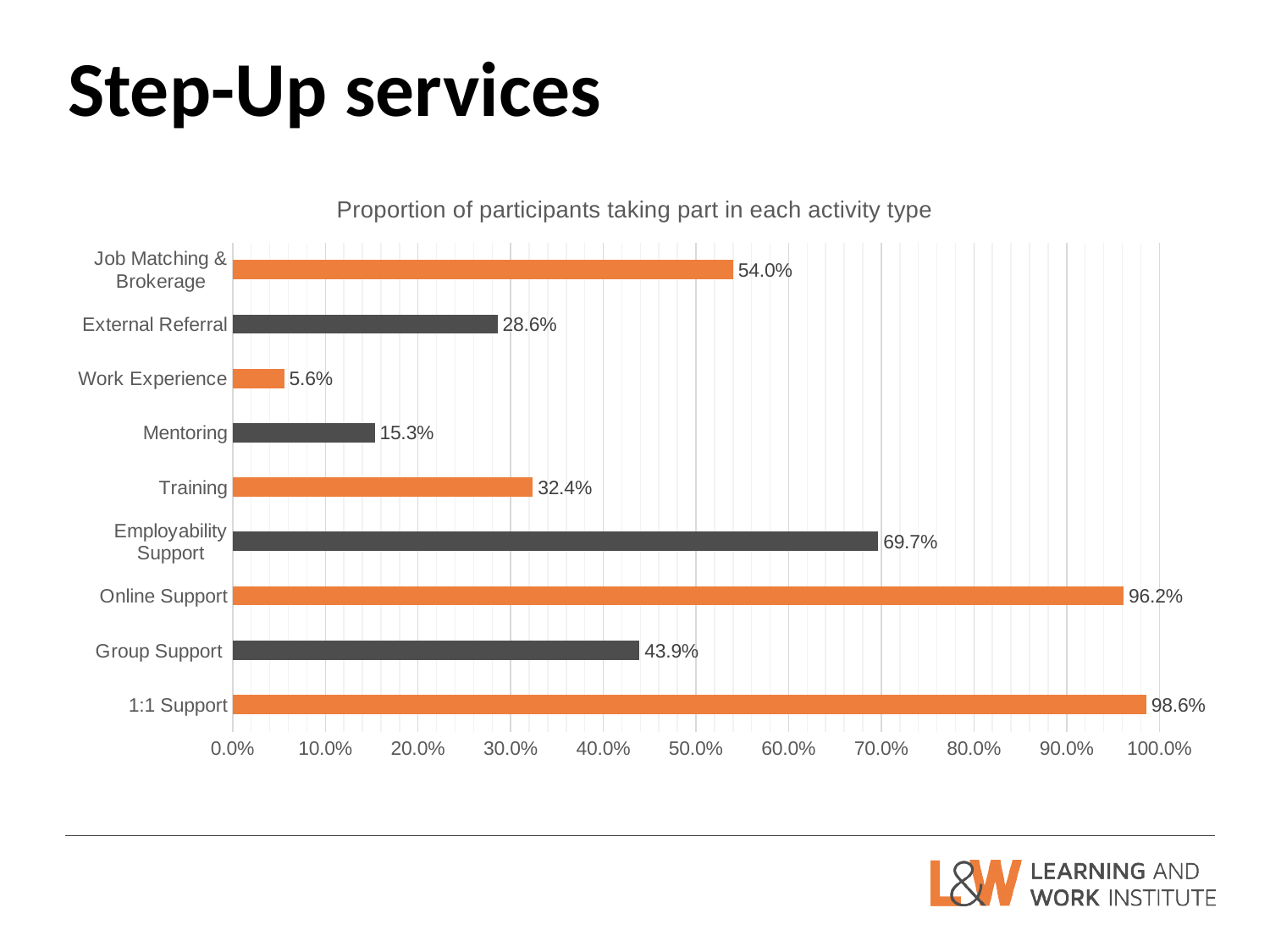
Which activity type has the lowest proportion of participants? Work Experience Which activity type has the highest proportion of participants? 1:1 Support What is the value shown for Job Matching & Brokerage? 54.0% What proportion of participants took part in Mentoring? 15.3% Is the value for Group Support greater or less than 50.0%? less What proportion of participants took part in Online Support? 96.2% What is the difference between the proportions for 1:1 Support and Online Support? 2.4% What is the title of the chart? Proportion of participants taking part in each activity type What is the difference between the proportions for Employability Support and Group Support? 25.8% How many activity types are shown in the chart? 9 Which has a higher proportion of participants, Training or External Referral? Training What kind of chart is shown on the slide? Bar chart